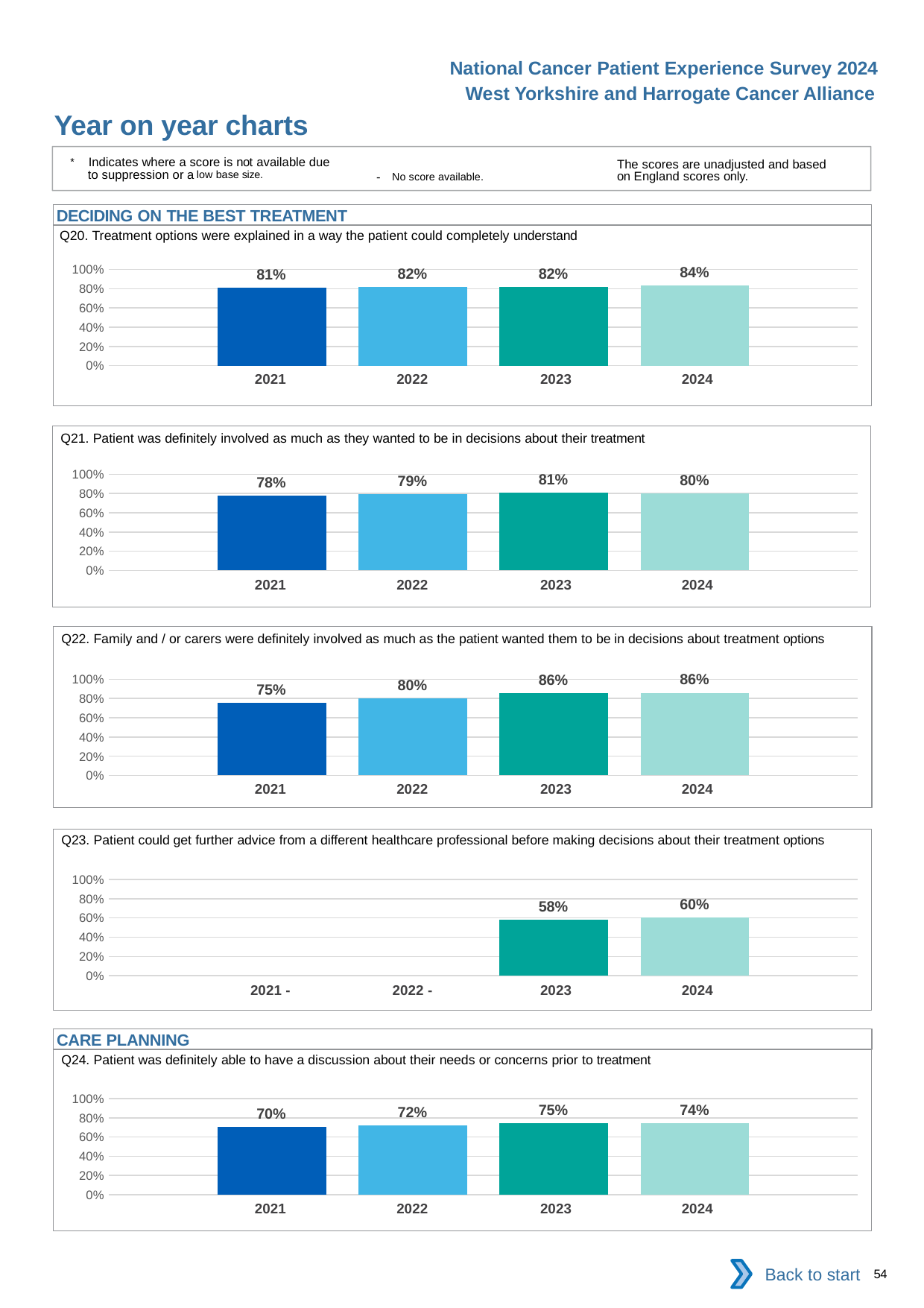
In the Q24 chart, which is larger, the value for 2022 or the value for 2023? 2023 In the Q23 chart, what is the value for 2023? 58% In the Q24 chart, which year has the lowest value? 2021 In the Q21 chart, which year has the highest value? 2023 In the Q22 chart, do the values rise or fall from 2021 to 2023? rise In the Q23 chart, how many years have a score shown as a bar? 2 In the Q20 chart, what is the difference between the 2021 and 2024 values? 3 percentage points In the Q22 chart, what is the difference between the 2021 and 2024 values? 11 percentage points What kind of chart is the Q21 chart? bar chart Which section heading appears above the Q24 chart? CARE PLANNING In the Q20 chart, what is the value for 2024? 84% In the Q21 chart, what is the value for 2022? 79%